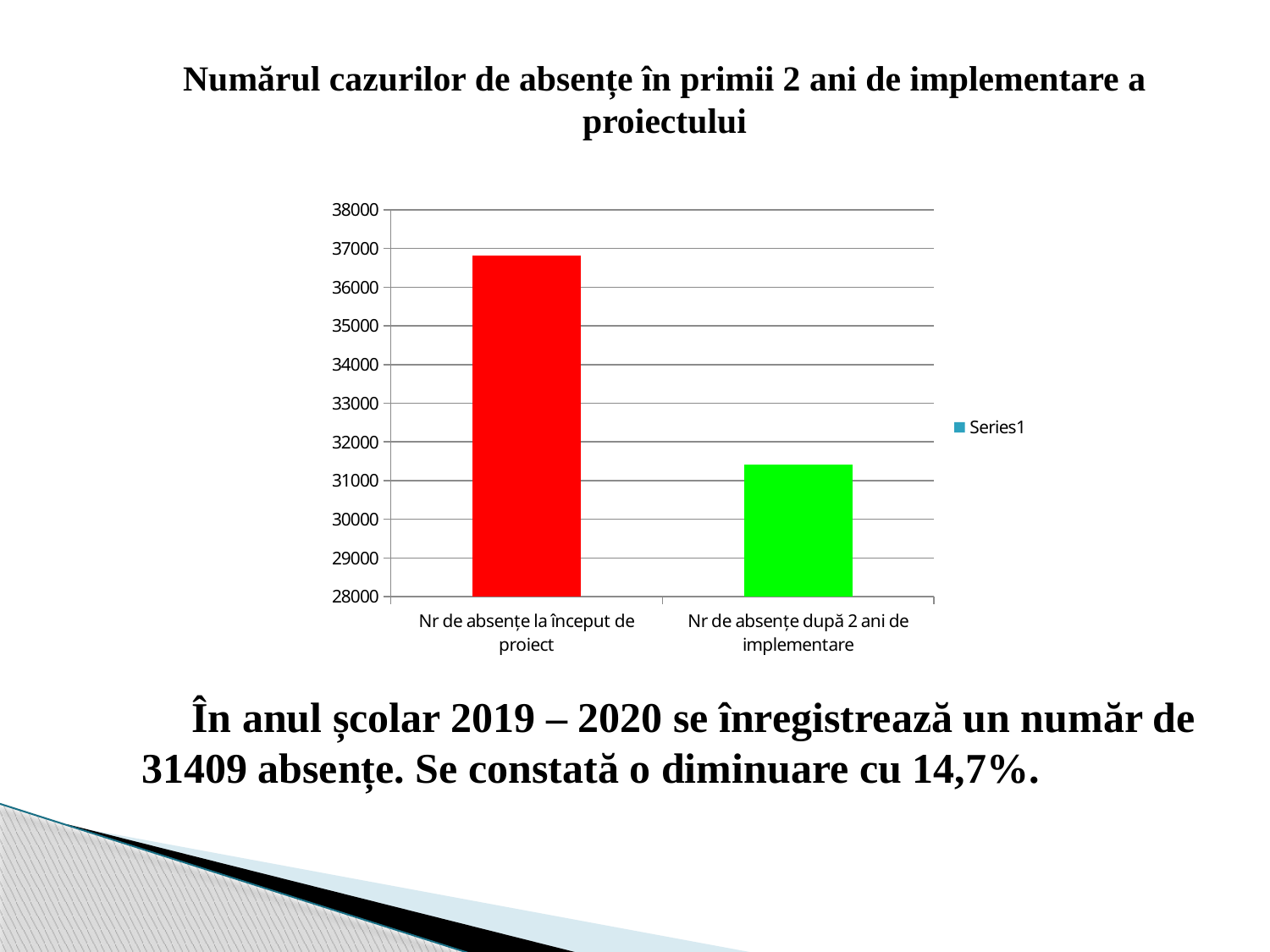
What colour is the bar for 'Nr de absențe după 2 ani de implementare'? green How many series does the legend list? 1 What is the title of the chart? Numărul cazurilor de absențe în primii 2 ani de implementare a proiectului Is the value for 'Nr de absențe după 2 ani de implementare' greater or less than 32000? less How many categories are plotted on the chart? 2 What kind of chart is shown on the slide? bar chart Is the value for 'Nr de absențe la început de proiect' greater or less than 36000? greater Do the values rise or fall from the first category to the second? fall Is the value for 'Nr de absențe după 2 ani de implementare' greater or less than 31000? greater Which is larger: the value for 'Nr de absențe la început de proiect' or for 'Nr de absențe după 2 ani de implementare'? Nr de absențe la început de proiect Which category has the lowest value? Nr de absențe după 2 ani de implementare Which category has the highest value? Nr de absențe la început de proiect